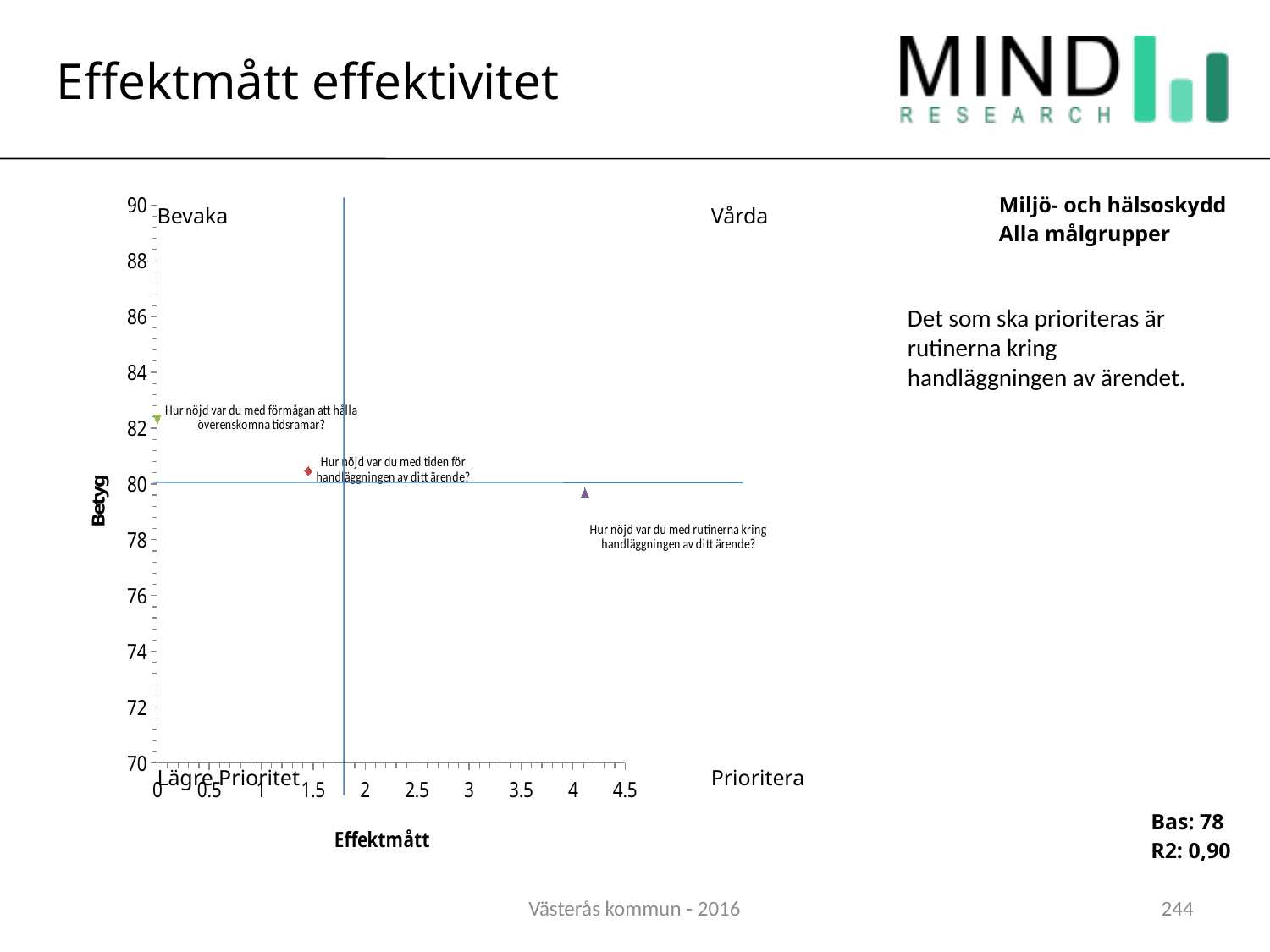
Which question has the highest Effektmått value in the chart? Hur nöjd var du med rutinerna kring handläggningen av ditt ärende? What is the title of the vertical axis of the chart? Betyg Which question has the lowest Effektmått value in the chart? Hur nöjd var du med förmågan att hålla överenskomna tidsramar? How many data points are plotted in the chart? 3 Which question has the highest Betyg value in the chart? Hur nöjd var du med förmågan att hålla överenskomna tidsramar? What is the title of the horizontal axis of the chart? Effektmått Is the Effektmått value for 'Hur nöjd var du med tiden för handläggningen av ditt ärende?' greater or less than 2? less Which has a higher Effektmått value: 'Hur nöjd var du med tiden för handläggningen av ditt ärende?' or 'Hur nöjd var du med rutinerna kring handläggningen av ditt ärende?' Hur nöjd var du med rutinerna kring handläggningen av ditt ärende? Is the Effektmått value for 'Hur nöjd var du med rutinerna kring handläggningen av ditt ärende?' greater or less than 3? greater What kind of chart is shown on the slide? Scatter chart Is the Betyg value for 'Hur nöjd var du med rutinerna kring handläggningen av ditt ärende?' greater or less than 82? less